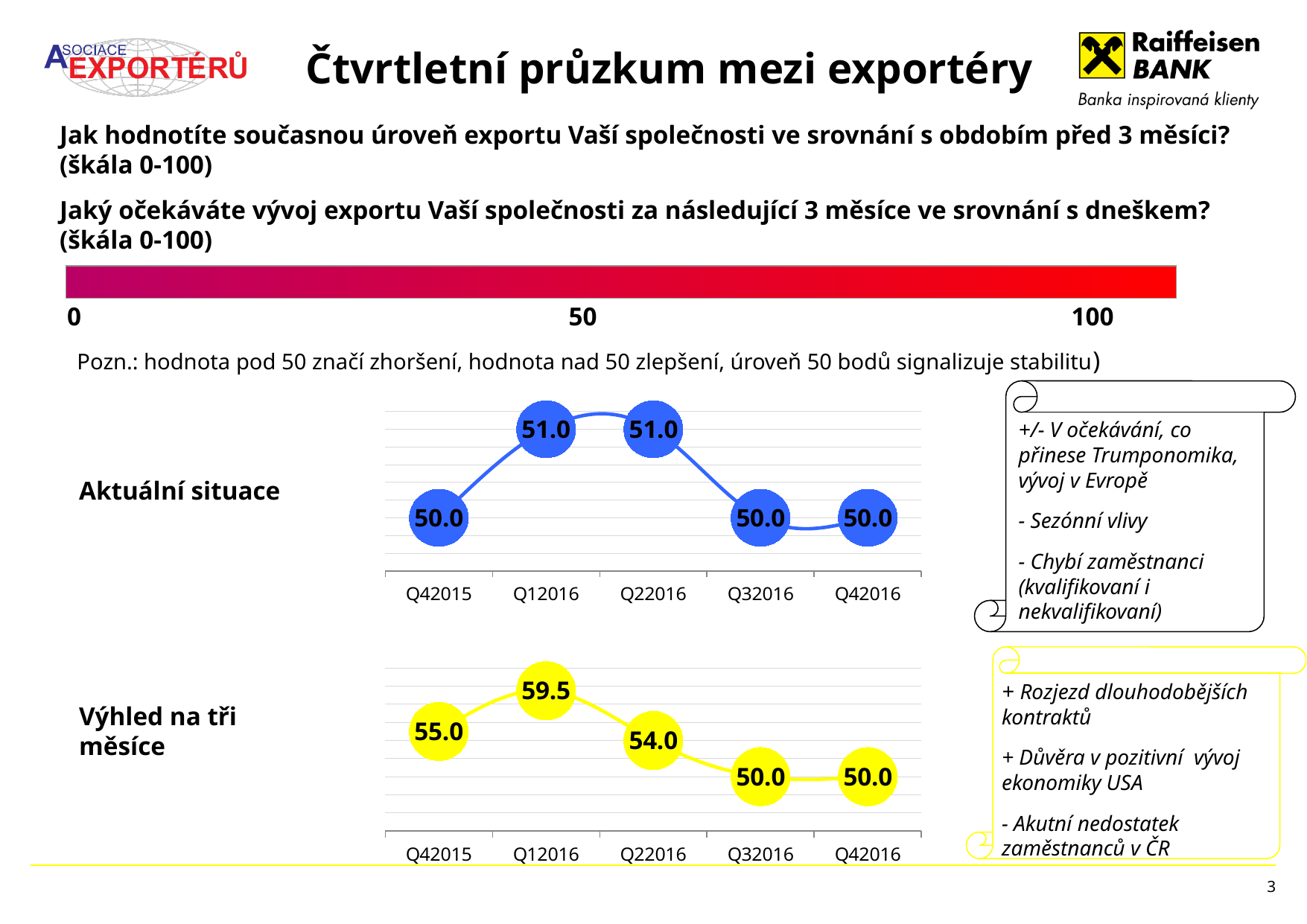
In the 'Aktuální situace' chart, what is the value for Q42016? 50.0 In the 'Aktuální situace' chart, which is larger, the value for Q22016 or the value for Q32016? Q22016 In the 'Aktuální situace' chart, what is the value for Q12016? 51.0 What kind of chart is the 'Výhled na tři měsíce' chart? Line chart How many data points are plotted in the 'Aktuální situace' chart? 5 What colour are the data point markers in the 'Aktuální situace' chart? Blue In the 'Výhled na tři měsíce' chart, which quarter has the highest value? Q12016 In the 'Výhled na tři měsíce' chart, what is the difference between the Q12016 value and the Q42015 value? 4.5 In the 'Výhled na tři měsíce' chart, what is the difference between the Q22016 value and the Q32016 value? 4.0 In the 'Výhled na tři měsíce' chart, what is the value for Q12016? 59.5 In the 'Výhled na tři měsíce' chart, do the values rise or fall from Q12016 to Q42016? Fall In the 'Výhled na tři měsíce' chart, what is the value for Q22016? 54.0